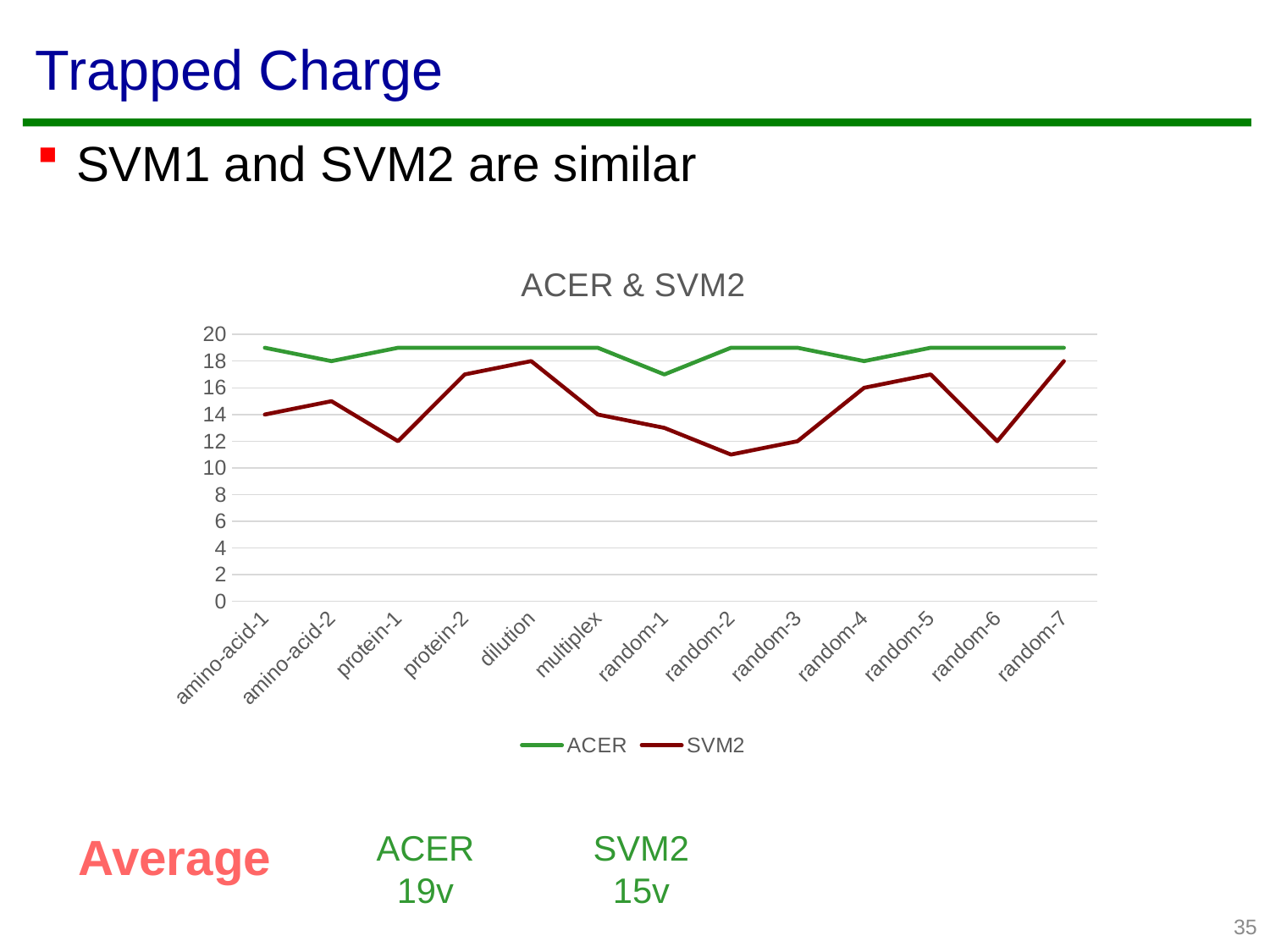
Is the SVM2 value for random-2 greater or less than 12? less What type of chart is shown on the slide? line chart What is the SVM2 value for random-4? 16 What is the SVM2 value for dilution? 18 How many categories are plotted along the x axis? 13 For which category is the SVM2 value lowest? random-2 For which category is the ACER value lowest? random-1 What is the SVM2 value for protein-1? 12 What is the difference between the SVM2 values for dilution and protein-1? 6 What is the title of the chart? ACER & SVM2 What is the ACER value for random-4? 18 How many series does the legend list? 2